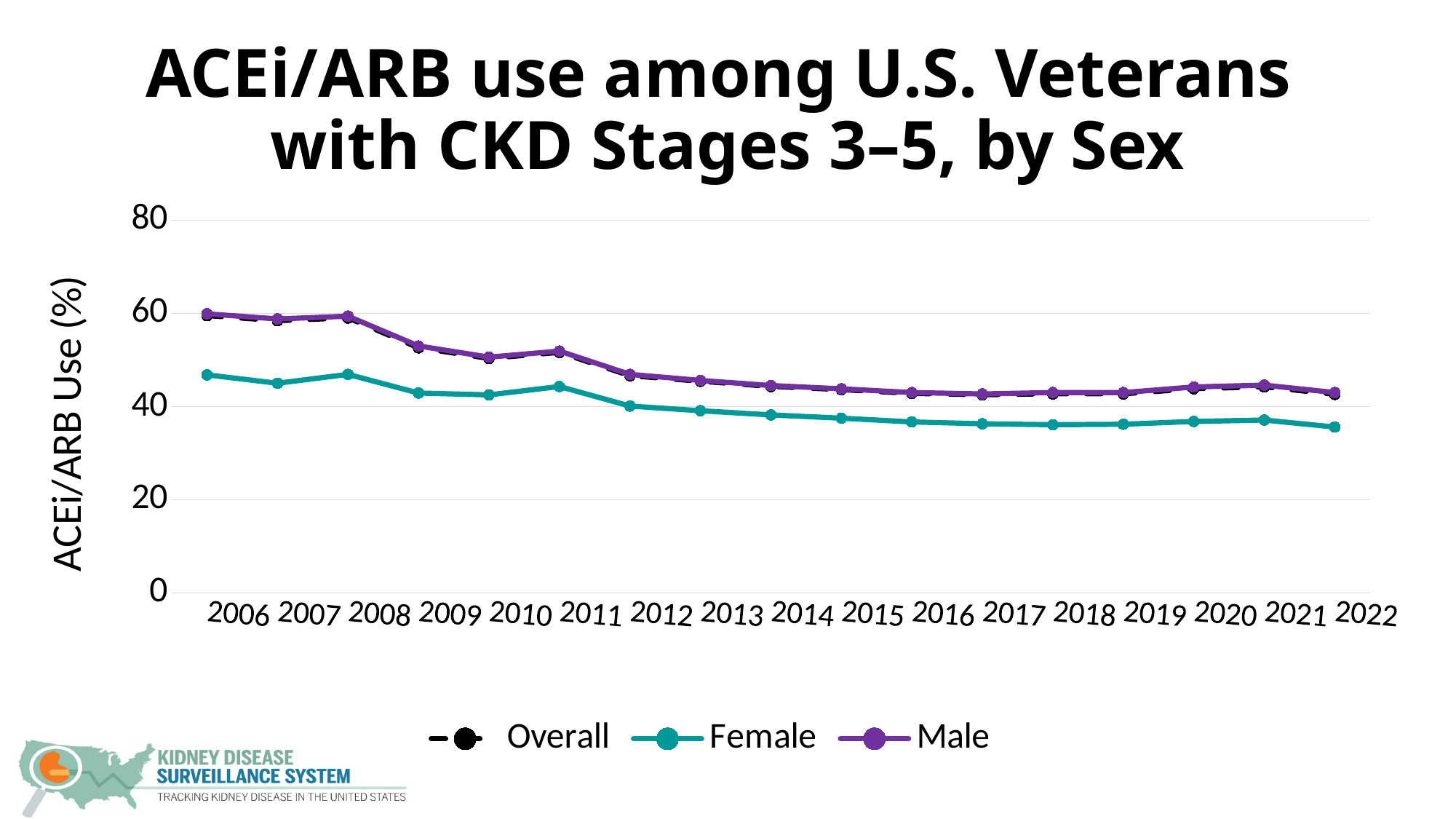
How many years are plotted along the x axis? 17 Is the value for Female in 2022 greater or less than 40? less Is the value for Female in 2006 greater or less than 40? greater Which is larger in 2022, the Overall value or the Female value? Overall Do the Female values generally rise or fall from 2006 to 2022? Fall Is the value for Male in 2006 greater or less than 40? greater What kind of chart is shown on the slide? Line chart Which is larger in 2010, the Male value or the Female value? Male How many series does the legend list? 3 Do the Male values generally rise or fall from 2006 to 2022? Fall What is the label on the y axis? ACEi/ARB Use (%)